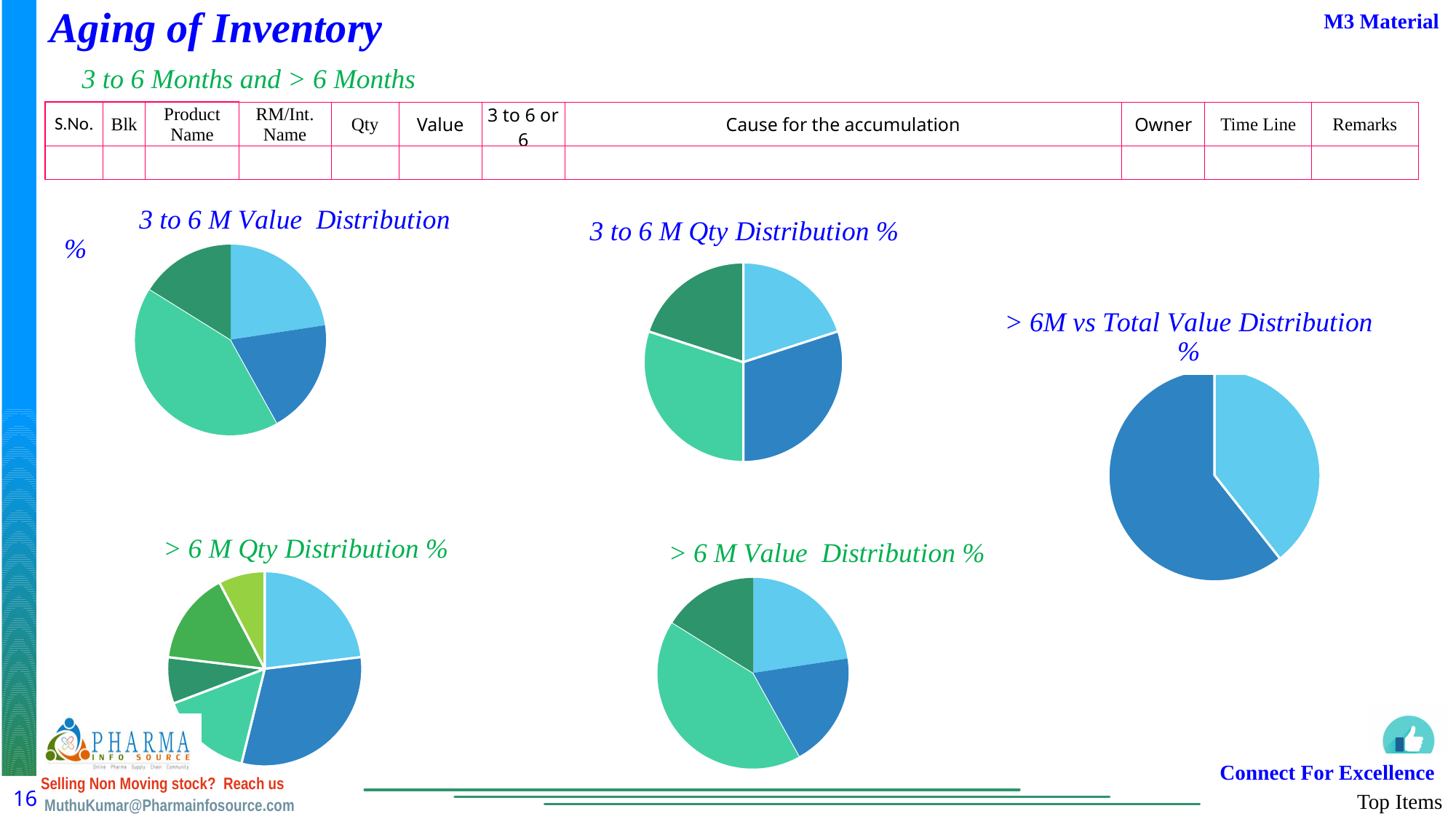
In the "3 to 6 M Value Distribution %" pie chart, which colour slice is the largest? Teal green How many slices does the "3 to 6 M Value Distribution %" pie chart have? 4 What kind of chart is the "3 to 6 M Value Distribution %" chart? Pie chart How many charts are shown on the slide? 5 In the "> 6M vs Total Value Distribution %" pie chart, which colour slice is larger, the dark blue or the light blue? Dark blue How many slices does the "3 to 6 M Qty Distribution %" pie chart have? 4 In the "> 6 M Value Distribution %" pie chart, which colour slice is the largest? Teal green What is the title of the pie chart on the right side of the slide? > 6M vs Total Value Distribution %